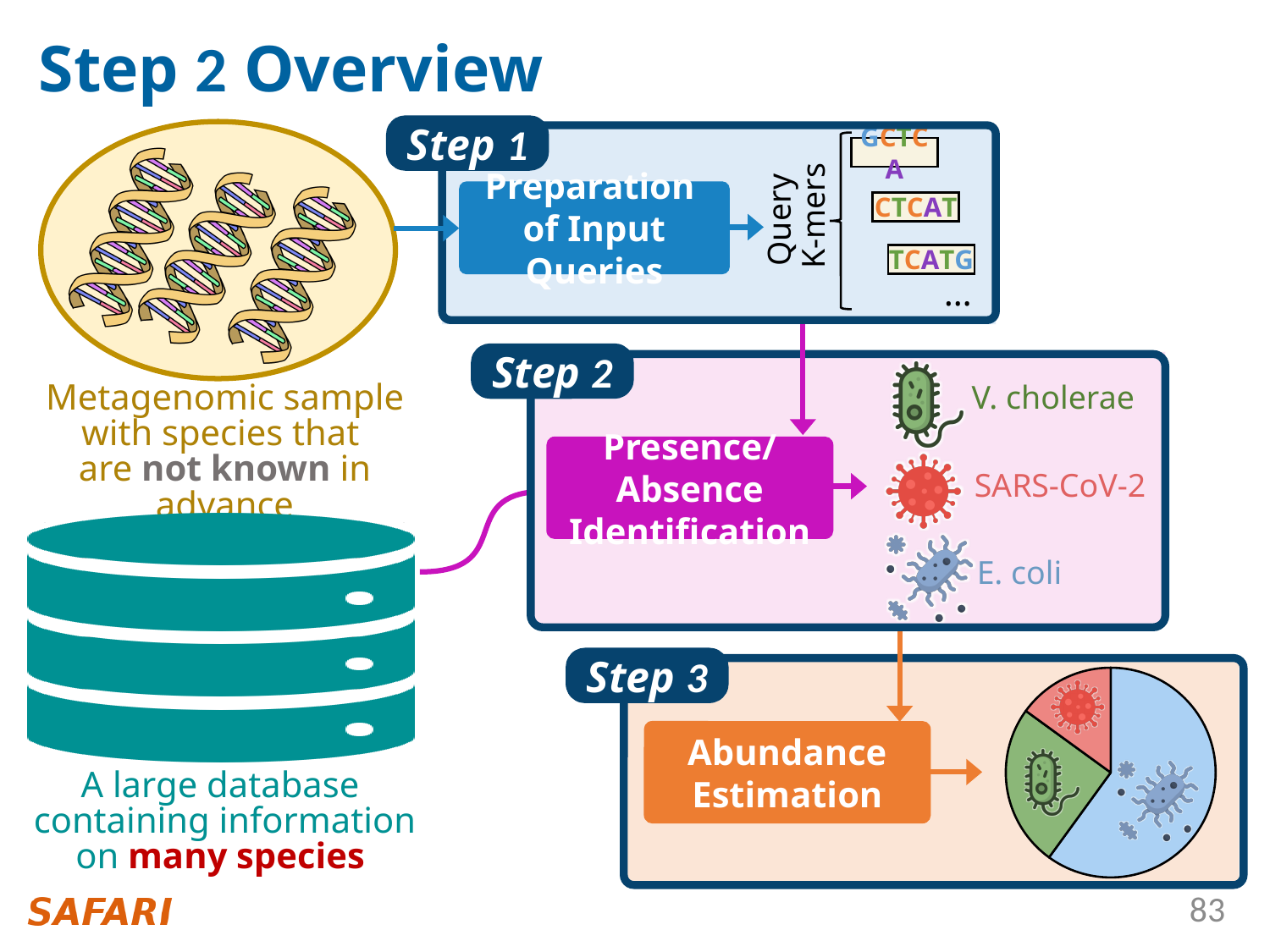
Which step's box contains the pie chart on the slide? Step 3 What colour is the slice containing the bacterium icon in the Step 3 pie chart? green What kind of chart is shown in the Step 3 box? pie chart In the Step 3 pie chart, does the blue slice take up more or less than half of the pie? more In the Step 3 pie chart, which slice is the largest? the blue slice (E. coli) In the Step 3 pie chart, is the blue slice larger or smaller than the red slice? larger How many slices does the pie chart in the Step 3 box have? 3